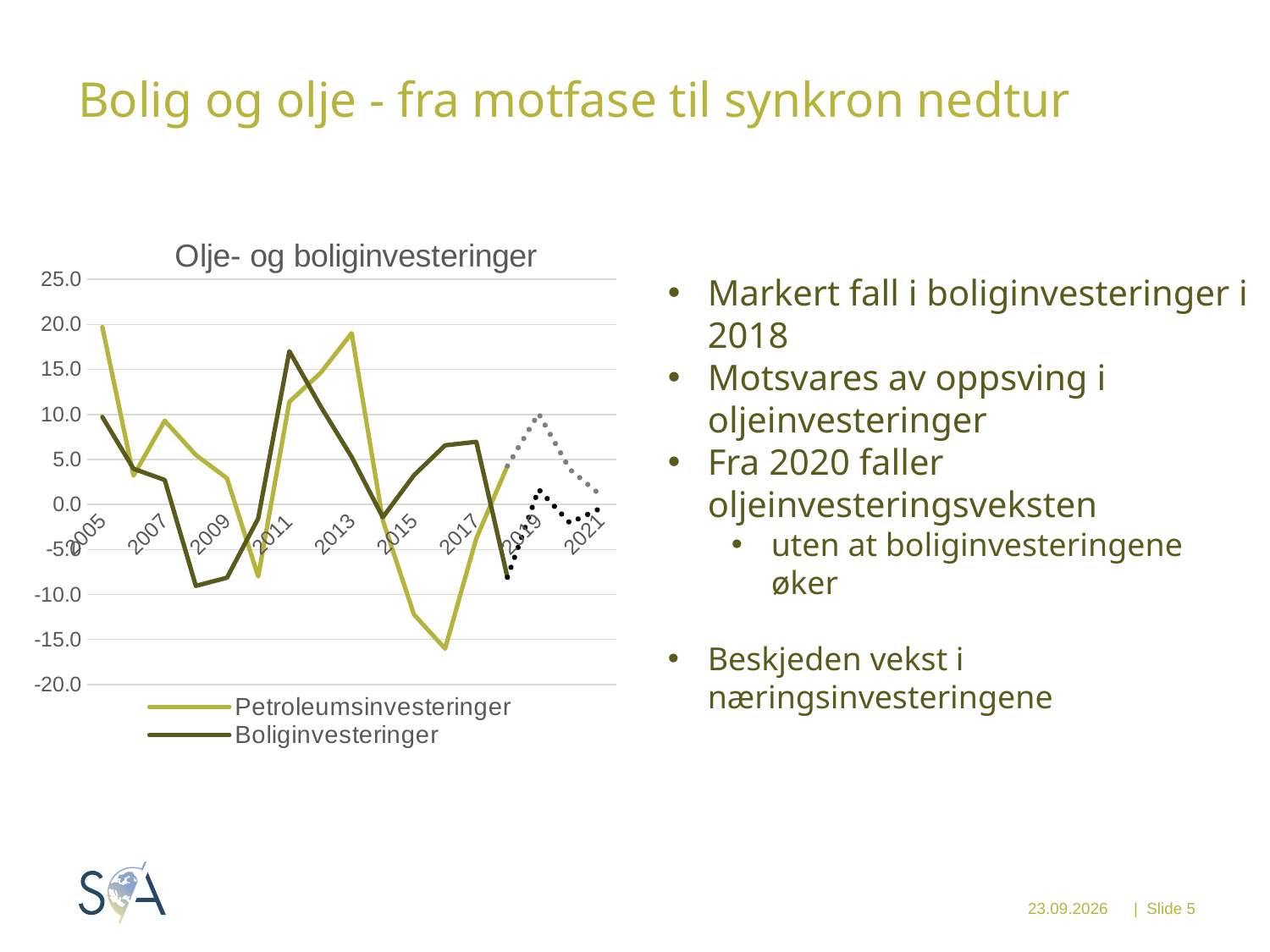
How many series does the chart legend list? 2 What kind of chart is shown on the slide? line chart What is the title of the chart? Olje- og boliginvesteringer Is the value for Petroleumsinvesteringer in 2005 greater or less than 15.0? greater In 2011, which series has the higher value, Petroleumsinvesteringer or Boliginvesteringer? Boliginvesteringer Which two series are listed in the chart legend? Petroleumsinvesteringer and Boliginvesteringer In which year does Petroleumsinvesteringer reach its lowest value? 2016 Is the value for Boliginvesteringer in 2011 greater or less than 15.0? greater In 2005, which series has the higher value, Petroleumsinvesteringer or Boliginvesteringer? Petroleumsinvesteringer Does Petroleumsinvesteringer rise or fall between 2013 and 2016? fall Is the value for Petroleumsinvesteringer in 2016 greater or less than -10.0? less